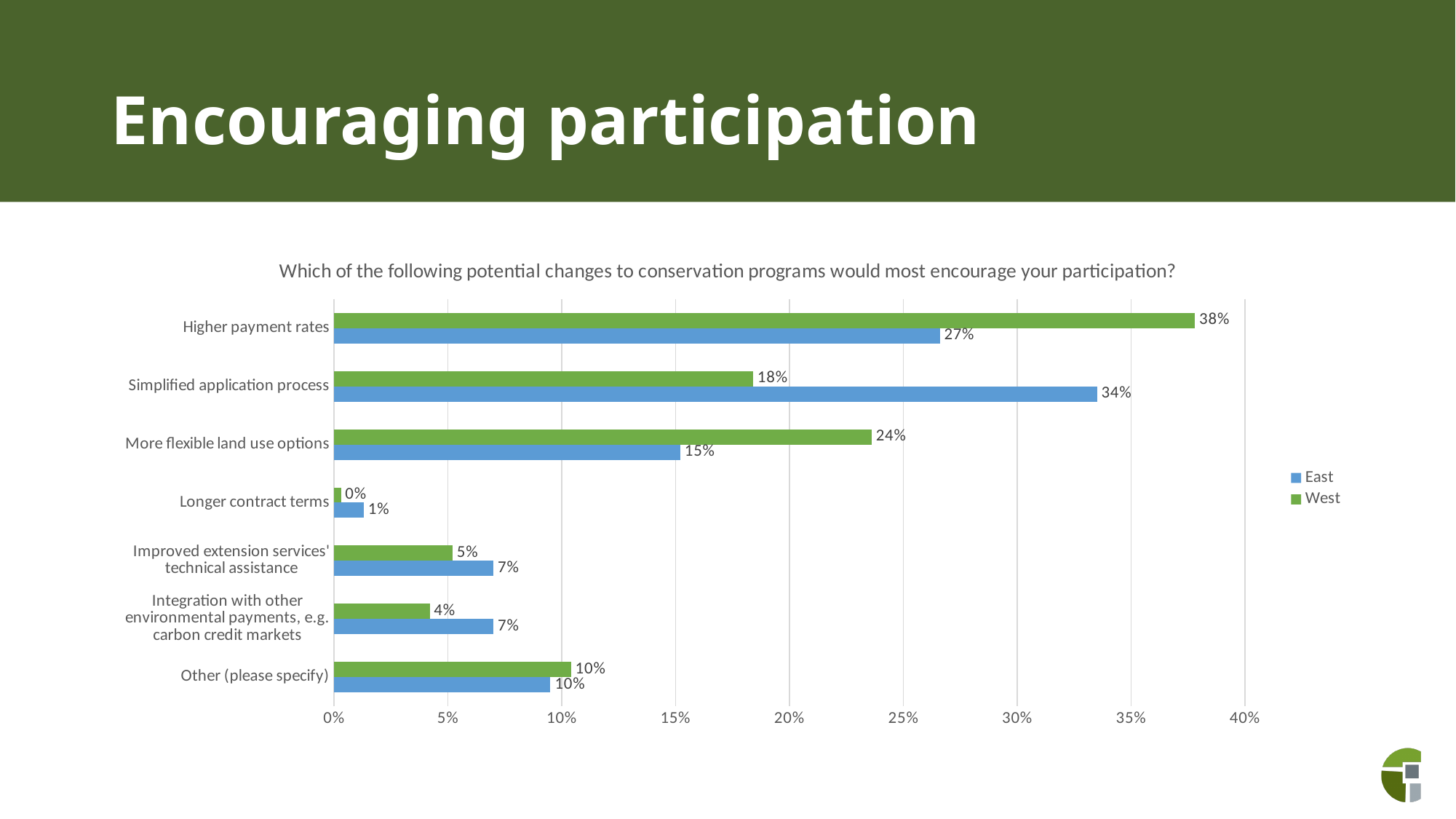
What is the difference between the West and East values for Higher payment rates? 11% How many series does the legend list? 2 What kind of chart is shown on the slide? Bar chart What is the East value for Simplified application process? 34% What is the difference between the East and West values for Simplified application process? 16% What is the West value for Higher payment rates? 38% Which category has the highest East value? Simplified application process What is the East value for More flexible land use options? 15% Which category has the lowest West value? Longer contract terms For More flexible land use options, which series has the larger value, East or West? West Which colour represents the West series in the chart? Green How many categories are shown on the chart? 7